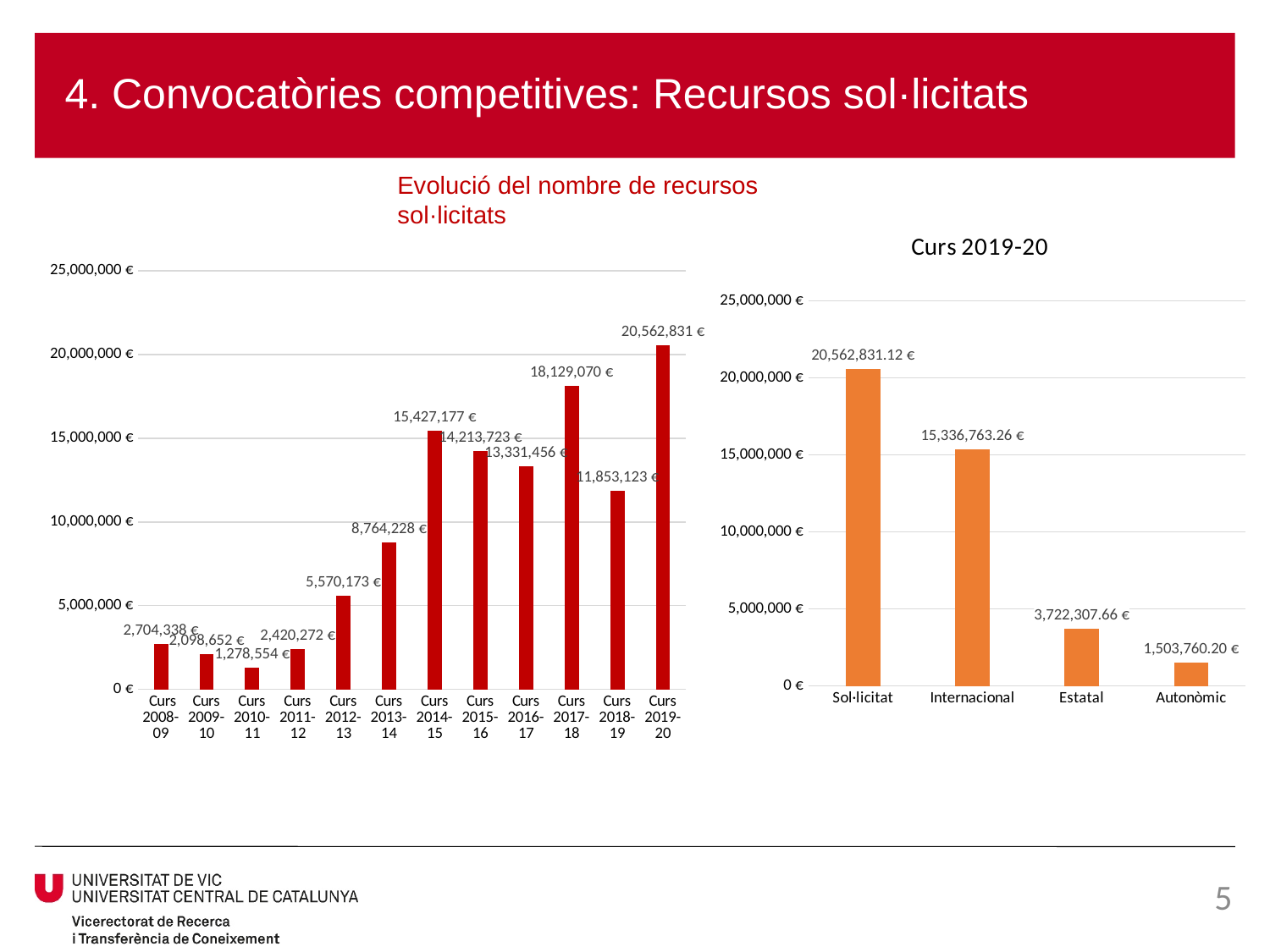
In the 'Evolució del nombre de recursos sol·licitats' chart, which course has the highest value? Curs 2019-20 In the 'Curs 2019-20' chart, which category has the lowest value? Autonòmic In the 'Curs 2019-20' chart, what is the difference between Estatal and Autonòmic? 2,218,547.46 € In the 'Evolució del nombre de recursos sol·licitats' chart, what is the difference between Curs 2019-20 and Curs 2018-19? 8,709,708 € How many courses are shown in the 'Evolució del nombre de recursos sol·licitats' chart? 12 In the 'Evolució del nombre de recursos sol·licitats' chart, what is the value for Curs 2013-14? 8,764,228 € In the 'Evolució del nombre de recursos sol·licitats' chart, what is the value for Curs 2019-20? 20,562,831 € In the 'Curs 2019-20' chart, what is the value for Internacional? 15,336,763.26 € What kind of chart is the 'Curs 2019-20' chart? Bar chart In the 'Curs 2019-20' chart, what is the value for Autonòmic? 1,503,760.20 € In the 'Evolució del nombre de recursos sol·licitats' chart, which is larger: Curs 2014-15 or Curs 2015-16? Curs 2014-15 In the 'Evolució del nombre de recursos sol·licitats' chart, which course has the lowest value? Curs 2010-11